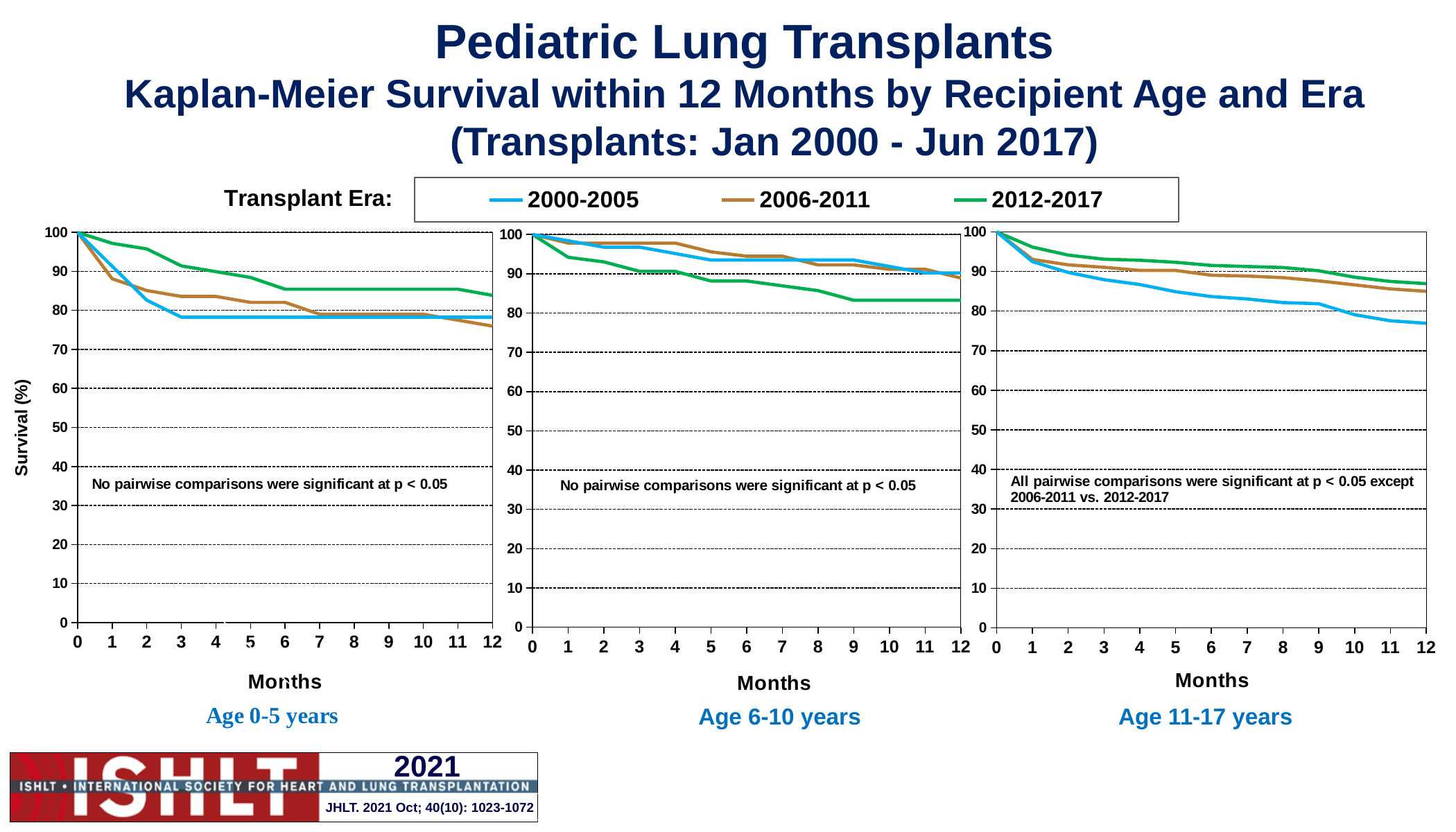
How many survival charts are shown on the slide? 3 In the Age 11-17 years chart, is the survival for 2000-2005 at 6 months greater or less than 90? less In the Age 0-5 years chart, which transplant era has the highest survival at 12 months? 2012-2017 What kind of chart is the Age 0-5 years chart? line chart In the Age 11-17 years chart, which era has higher survival at 12 months, 2000-2005 or 2012-2017? 2012-2017 According to the note in the Age 11-17 years chart, which pairwise comparison was not significant at p < 0.05? 2006-2011 vs. 2012-2017 What is the y-axis label of the charts? Survival (%) How many transplant eras does the legend list? 3 In the Age 11-17 years chart, do the survival curves rise or fall as months increase? fall In the Age 11-17 years chart, is the 12-month survival for 2000-2005 greater or less than 80? less In the Age 0-5 years chart, is the 12-month survival for 2012-2017 greater or less than 80? greater